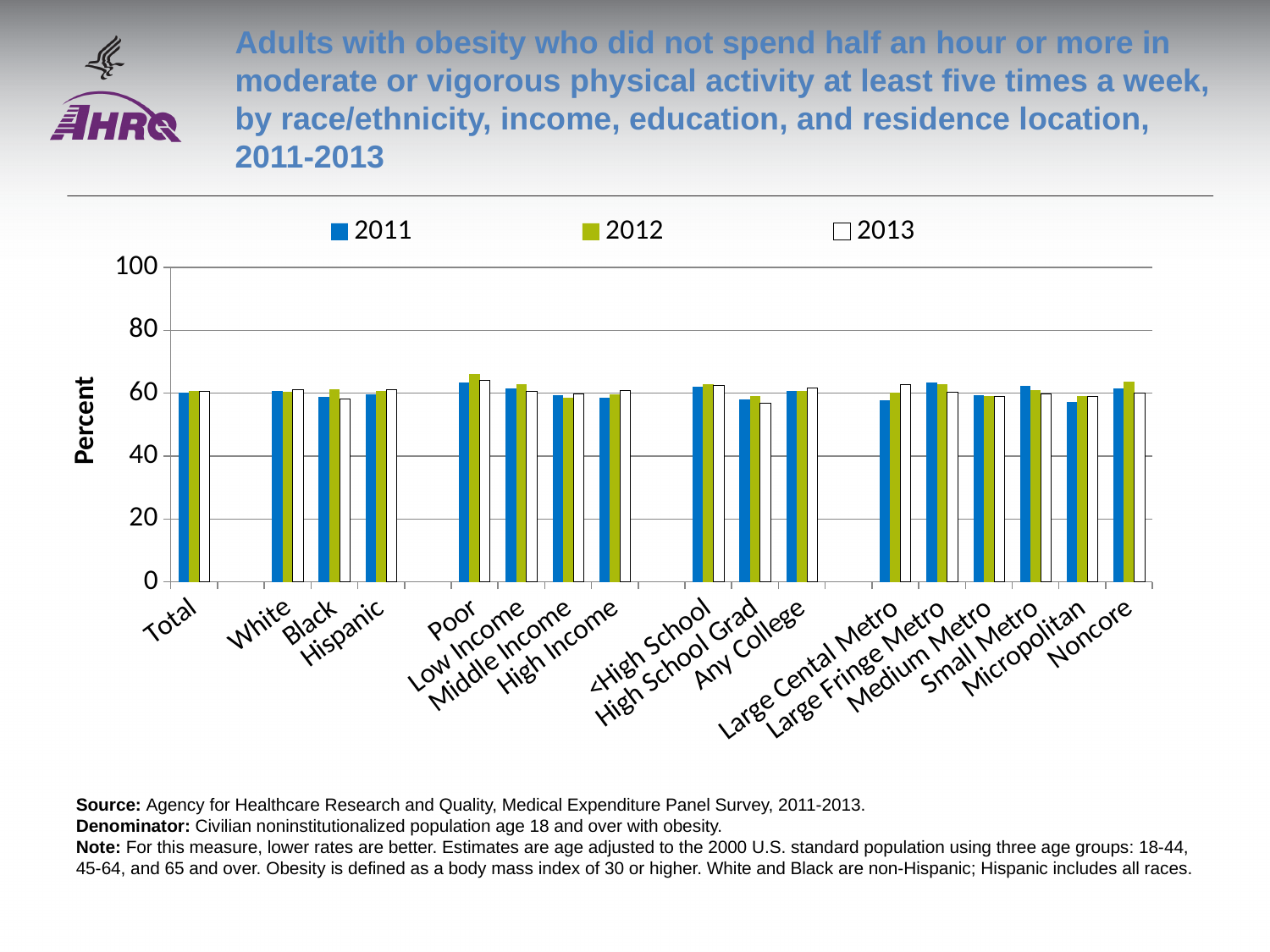
Is the value for Hispanic in 2012 greater or less than 20? greater How many series does the legend list? 3 Is the value for Poor in 2012 greater or less than 40? greater What kind of chart is shown on the slide? bar chart How many categories are shown along the x axis? 17 Which years are listed in the legend? 2011, 2012, 2013 Is the value for Noncore in 2013 greater or less than 80? less What is the label on the y axis? Percent